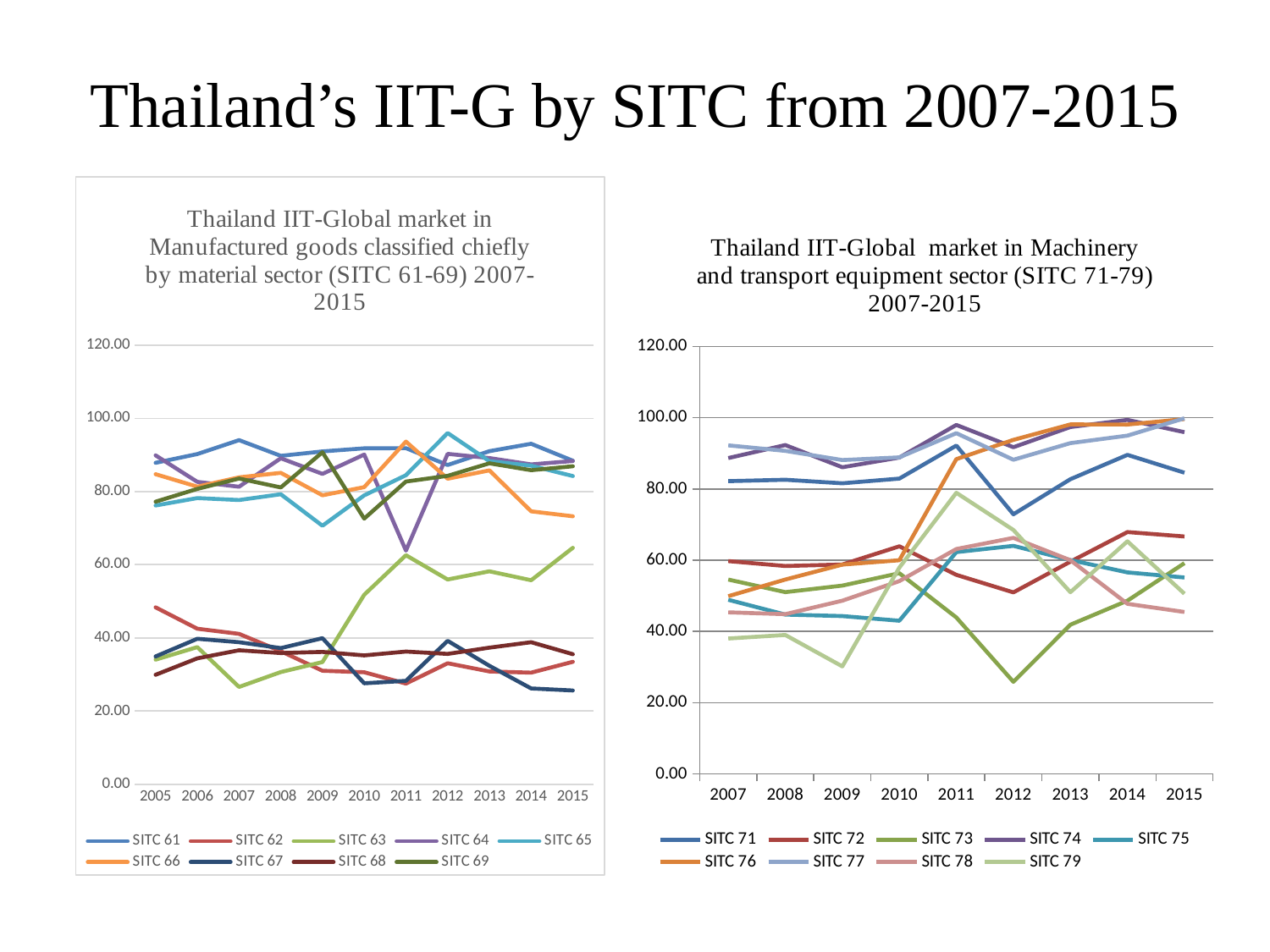
How many years are shown on the x axis of the right chart (SITC 71-79)? 9 In the right chart (SITC 71-79), which series has the lowest value in 2012? SITC 73 What type of chart is the left chart, 'Thailand IIT-Global market in Manufactured goods classified chiefly by material sector (SITC 61-69) 2007-2015'? Line chart In the right chart (SITC 71-79), which is larger in 2012: SITC 74 or SITC 79? SITC 74 In the left chart (SITC 61-69), is the value for SITC 61 in 2007 greater or less than 80.00? greater In the right chart (SITC 71-79), does the SITC 76 line rise or fall from 2007 to 2015? Rise In the right chart (SITC 71-79), is the value for SITC 79 in 2012 greater or less than 40.00? greater In the left chart (SITC 61-69), is the value for SITC 63 in 2007 greater or less than 40.00? less How many years are shown on the x axis of the left chart (SITC 61-69)? 11 In the left chart (SITC 61-69), which is larger in 2011: SITC 64 or SITC 66? SITC 66 How many series does the legend of the right chart, 'Thailand IIT-Global market in Machinery and transport equipment sector (SITC 71-79) 2007-2015', list? 9